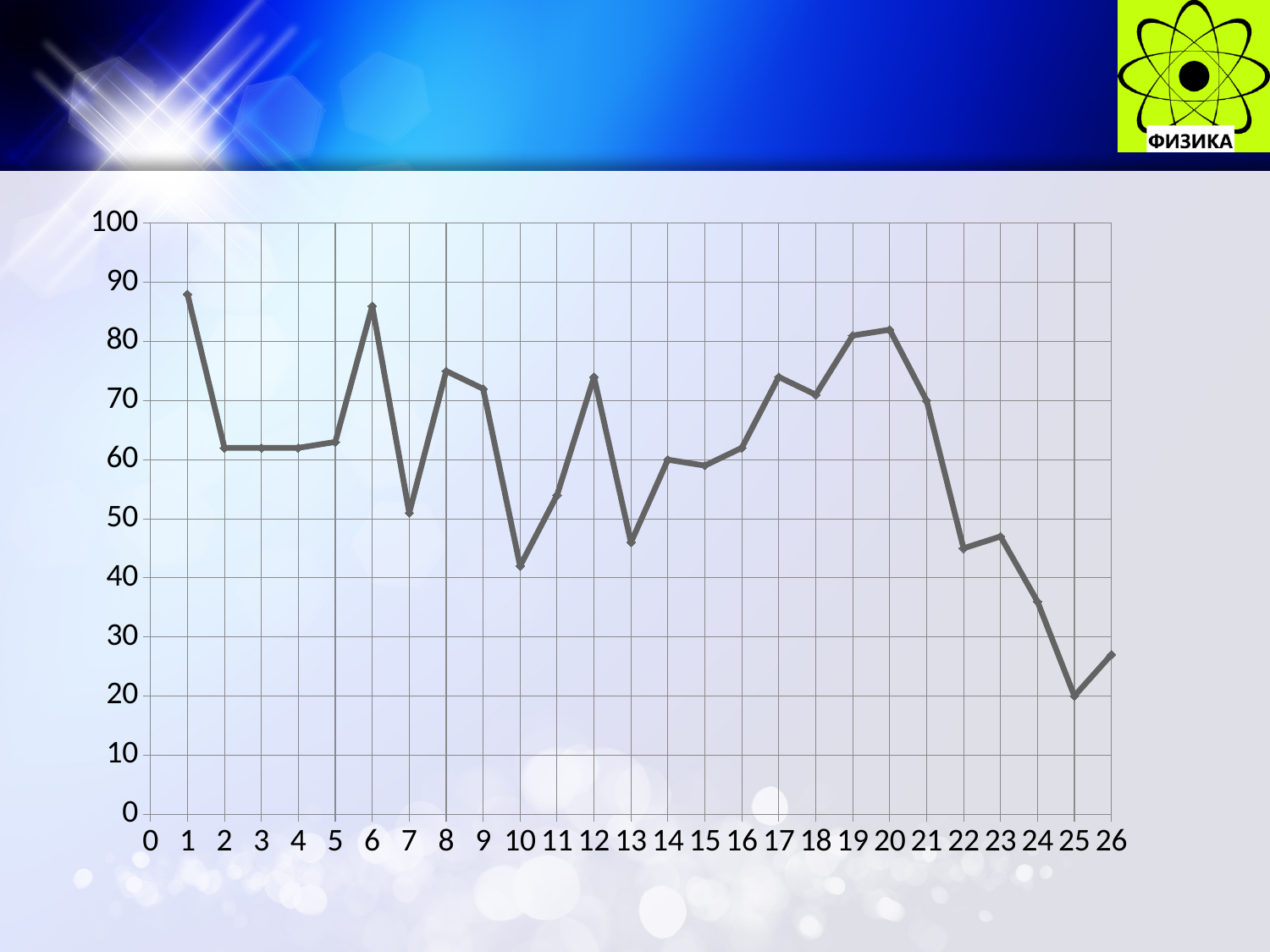
Is the value at x = 10 greater or less than 50? less Is the value at x = 25 greater or less than 30? less Is the value at x = 1 greater or less than 80? greater Which x-axis point has the lowest value on the line? 25 Which has the larger value, x = 13 or x = 19? 19 Which has the larger value, x = 6 or x = 7? 6 What kind of chart is shown on the slide? line chart What is the highest value shown on the vertical axis? 100 Do the values rise or fall along the x axis from x = 20 to x = 25? fall How many data points are plotted on the line? 26